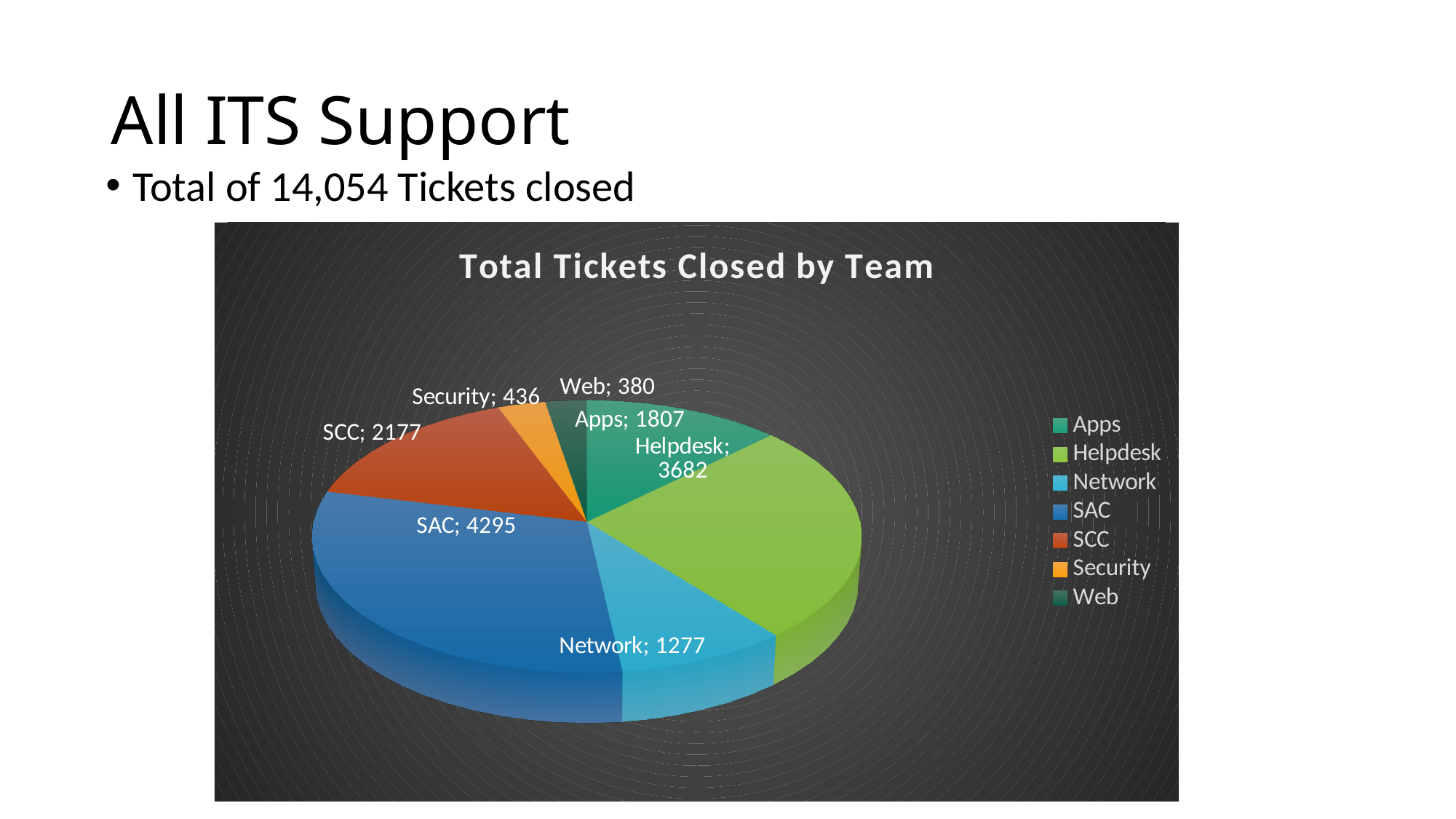
How many tickets did the Helpdesk team close according to the chart? 3682 How many tickets were closed by the Security team? 436 How many teams (slices) are shown in the pie chart? 7 What is the title of the chart? Total Tickets Closed by Team What is the difference between the SAC and Helpdesk ticket counts? 613 Which team closed the most tickets? SAC What type of chart is shown on the slide? Pie chart What is the value shown for the Network slice? 1277 How many more tickets did SCC close than Apps? 370 What is the total number of tickets across all slices of the pie chart? 14,054 Which team closed the fewest tickets? Web Which closed more tickets, Apps or Network? Apps